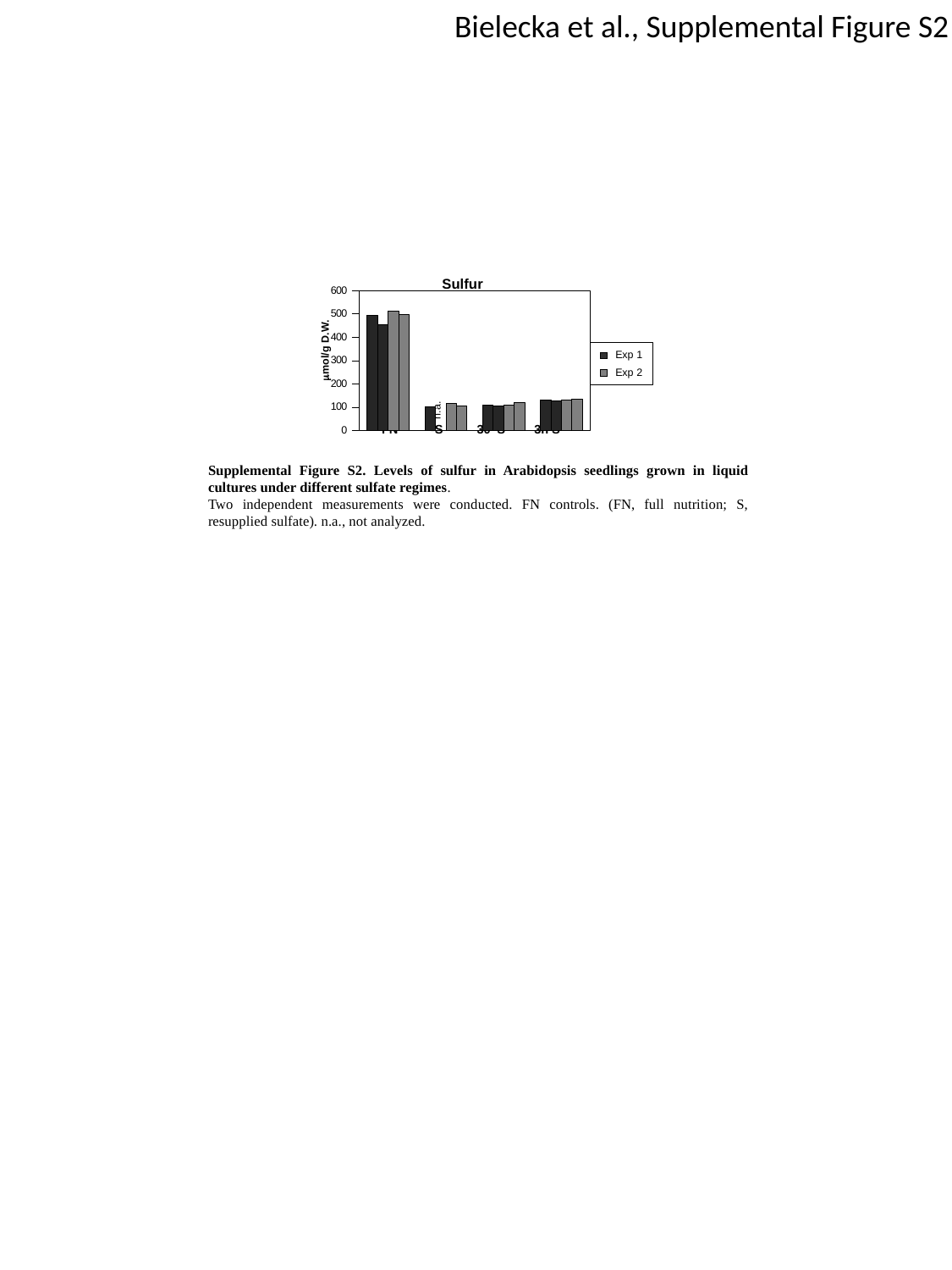
Are the values for FN greater or less than 400? greater Which is larger, the sulfur value for FN or for S? FN What is the title of the chart? Sulfur Which category has the highest sulfur values? FN Are the values for S greater or less than 200? less How many categories are shown on the x axis? 4 What kind of chart is shown on the slide? bar chart How many series does the legend list? 2 What is the maximum value shown on the y axis? 600 What are the two series named in the legend? Exp 1 and Exp 2